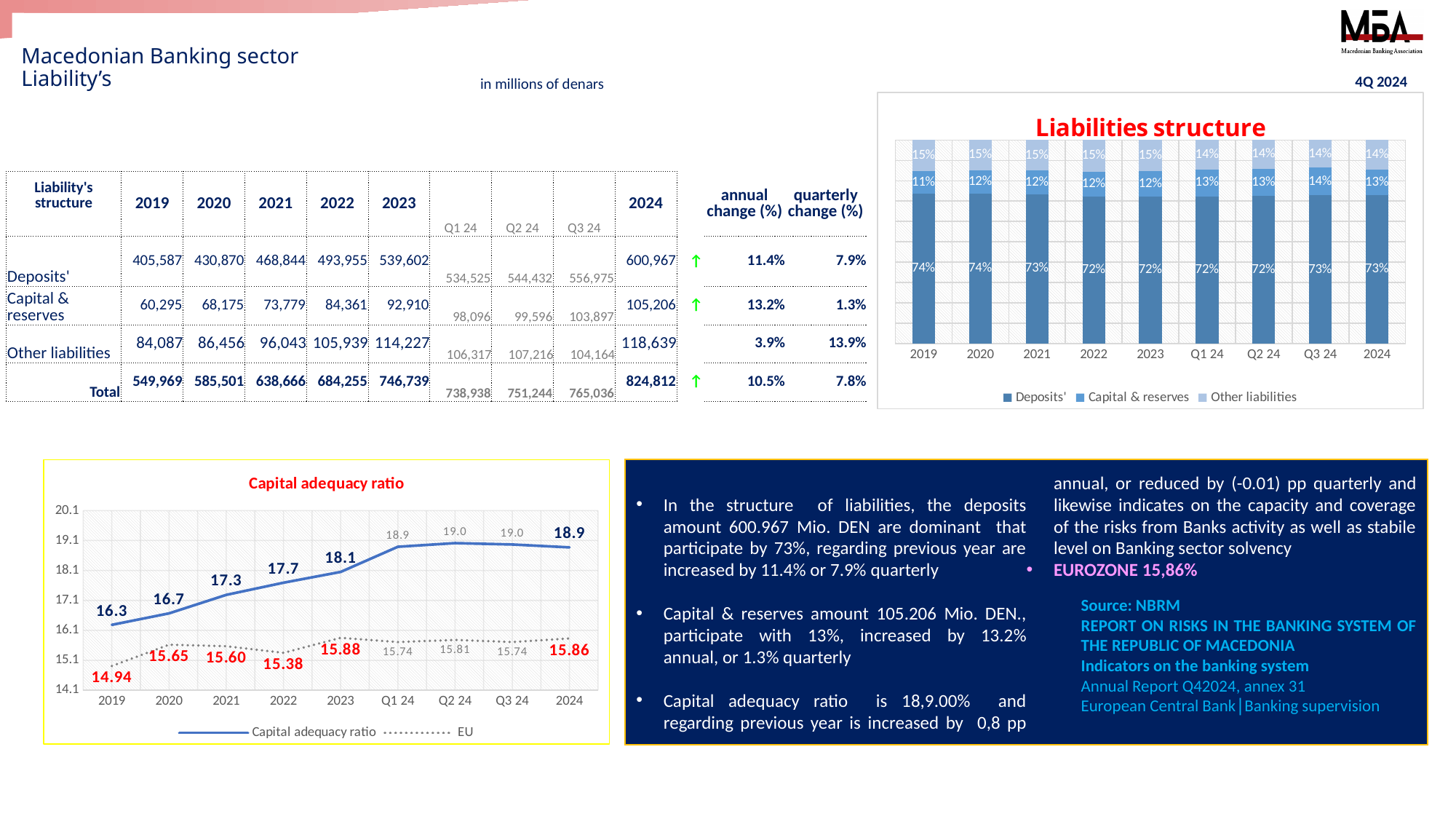
How many categories are shown on the x axis of the "Liabilities structure" chart? 9 In the "Liabilities structure" chart, what share do Other liabilities have in 2019? 15% In the "Capital adequacy ratio" chart, does the Capital adequacy ratio series rise or fall from 2019 to 2023? Rise How many series does the legend of the "Liabilities structure" chart list? 3 In the "Liabilities structure" chart, what share do Deposits' have in 2024? 73% In the "Capital adequacy ratio" chart, what is the EU value for 2019? 14.94 In the "Liabilities structure" chart, what share do Capital & reserves have in Q3 24? 14% In the "Capital adequacy ratio" chart, what is the Capital adequacy ratio value for 2023? 18.1 What type of chart is the "Liabilities structure" chart? Stacked bar chart In the "Capital adequacy ratio" chart, which is larger in 2022: the Capital adequacy ratio or the EU value? Capital adequacy ratio In the "Capital adequacy ratio" chart, which year has the lowest Capital adequacy ratio value? 2019 In the "Capital adequacy ratio" chart, what is the difference between the Capital adequacy ratio and the EU value in 2024? 3.04